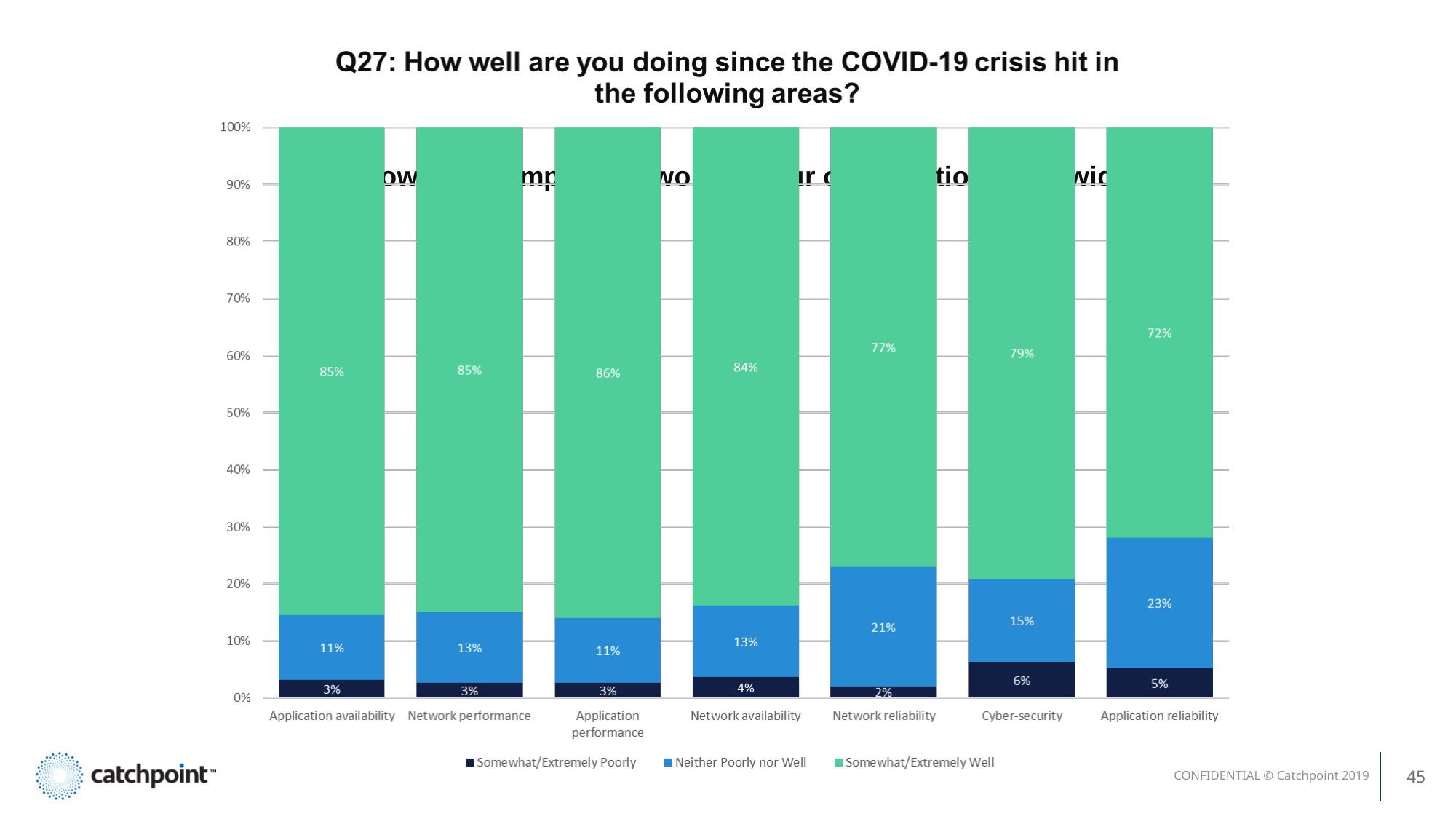
Which area has the highest Somewhat/Extremely Well percentage? Application performance Which area has the lowest Somewhat/Extremely Poorly percentage? Network reliability What is the Somewhat/Extremely Poorly value for Cyber-security? 6% Which has a larger Somewhat/Extremely Well value, Network reliability or Cyber-security? Cyber-security Which area has the lowest Somewhat/Extremely Well percentage? Application reliability What percentage of respondents said they are doing Somewhat/Extremely Well in Application reliability? 72% What is the Neither Poorly nor Well value for Network reliability? 21% How many percentage points higher is the Neither Poorly nor Well value for Application reliability than for Application availability? 12 percentage points Which area has the highest Neither Poorly nor Well percentage? Application reliability How many areas are shown on the x axis of the chart? 7 How many series does the legend list? 3 What kind of chart is shown on the slide? Stacked bar chart